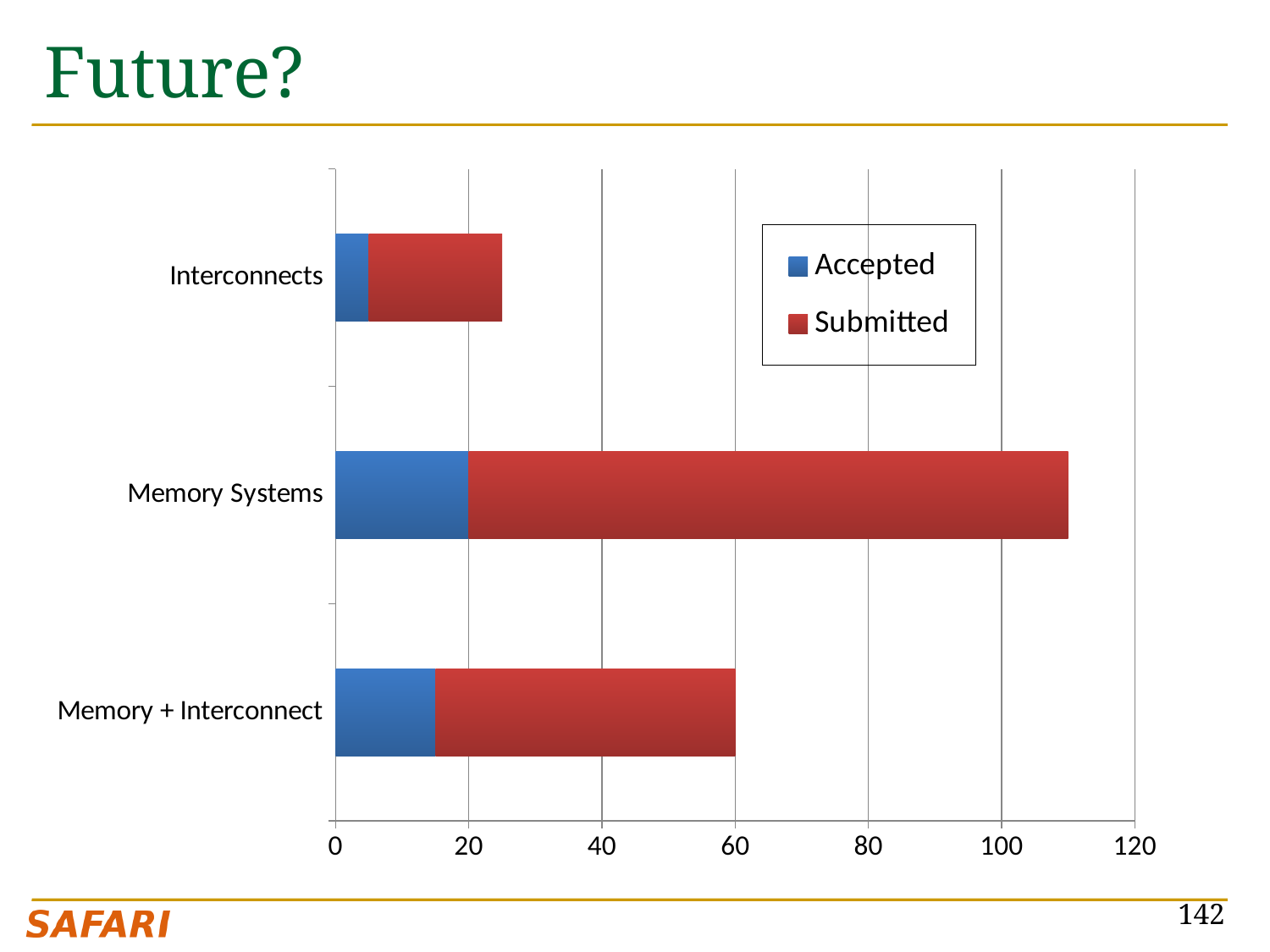
What kind of chart is shown on the slide? bar chart Which category has the longest total bar? Memory Systems What is the Accepted value for Memory Systems? 20 How many series does the legend list? 2 Which category has the shortest total bar? Interconnects Which has a larger total bar, Memory Systems or Memory + Interconnect? Memory Systems Which series is shown in blue in the legend? Accepted Is the total value for Interconnects greater or less than 20? greater How many categories are shown on the chart? 3 What is the total length of the stacked bar for Memory + Interconnect? 60 Is the total value for Memory Systems greater or less than 100? greater Is the Accepted value for Memory + Interconnect greater or less than 20? less